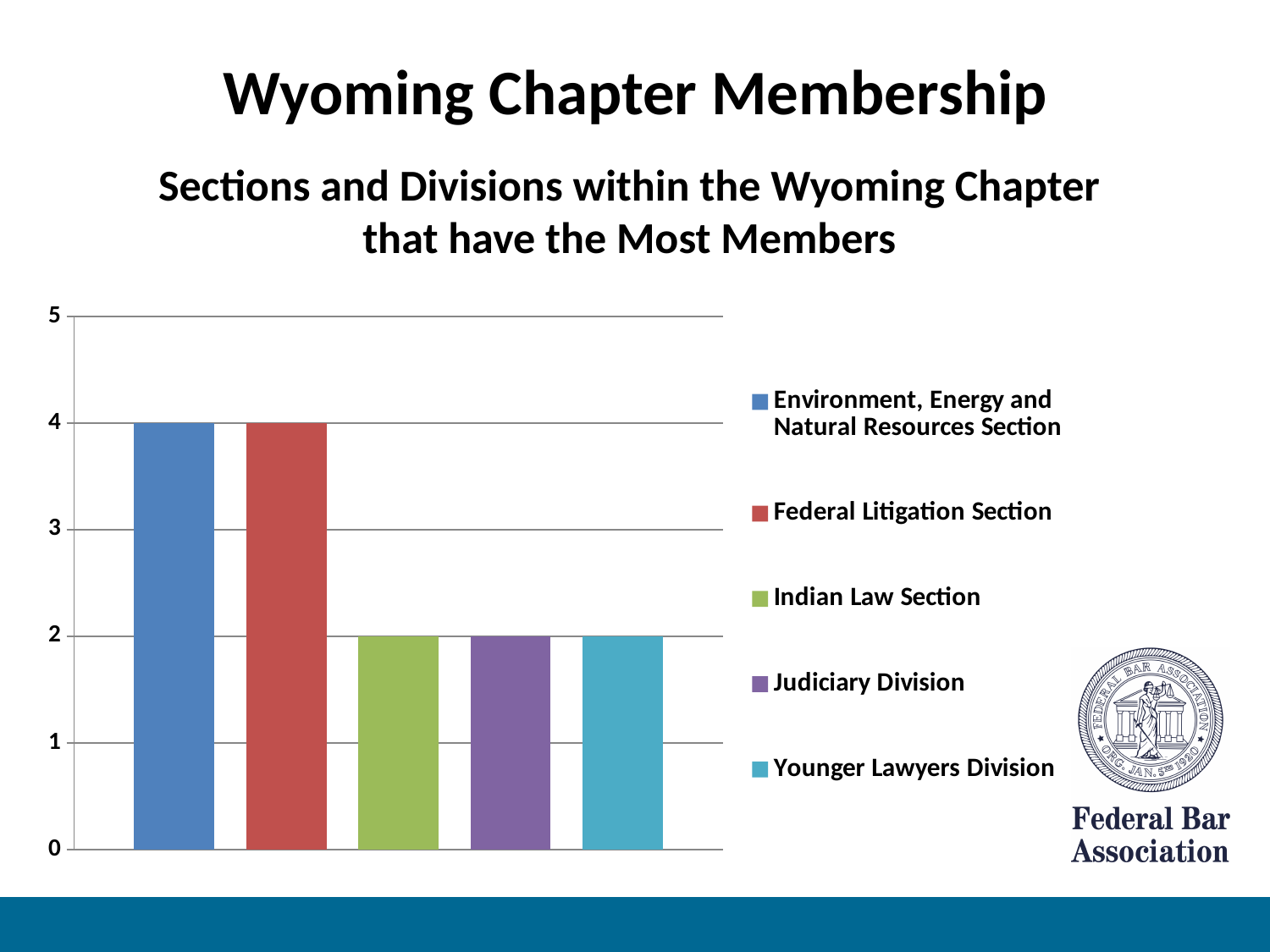
What is the value for the Judiciary Division? 2 Is the value for the Judiciary Division greater or less than 3? less What kind of chart is shown on the slide? bar chart How many bars are plotted in the chart? 5 How many series does the legend list? 5 What is the value for the Younger Lawyers Division? 2 What is the difference between the value for the Environment, Energy and Natural Resources Section and the value for the Indian Law Section? 2 What is the value for the Indian Law Section? 2 What is the value for the Environment, Energy and Natural Resources Section? 4 What is the title of the chart? Sections and Divisions within the Wyoming Chapter that have the Most Members Which is larger, the value for the Federal Litigation Section or the value for the Younger Lawyers Division? Federal Litigation Section What is the value for the Federal Litigation Section? 4